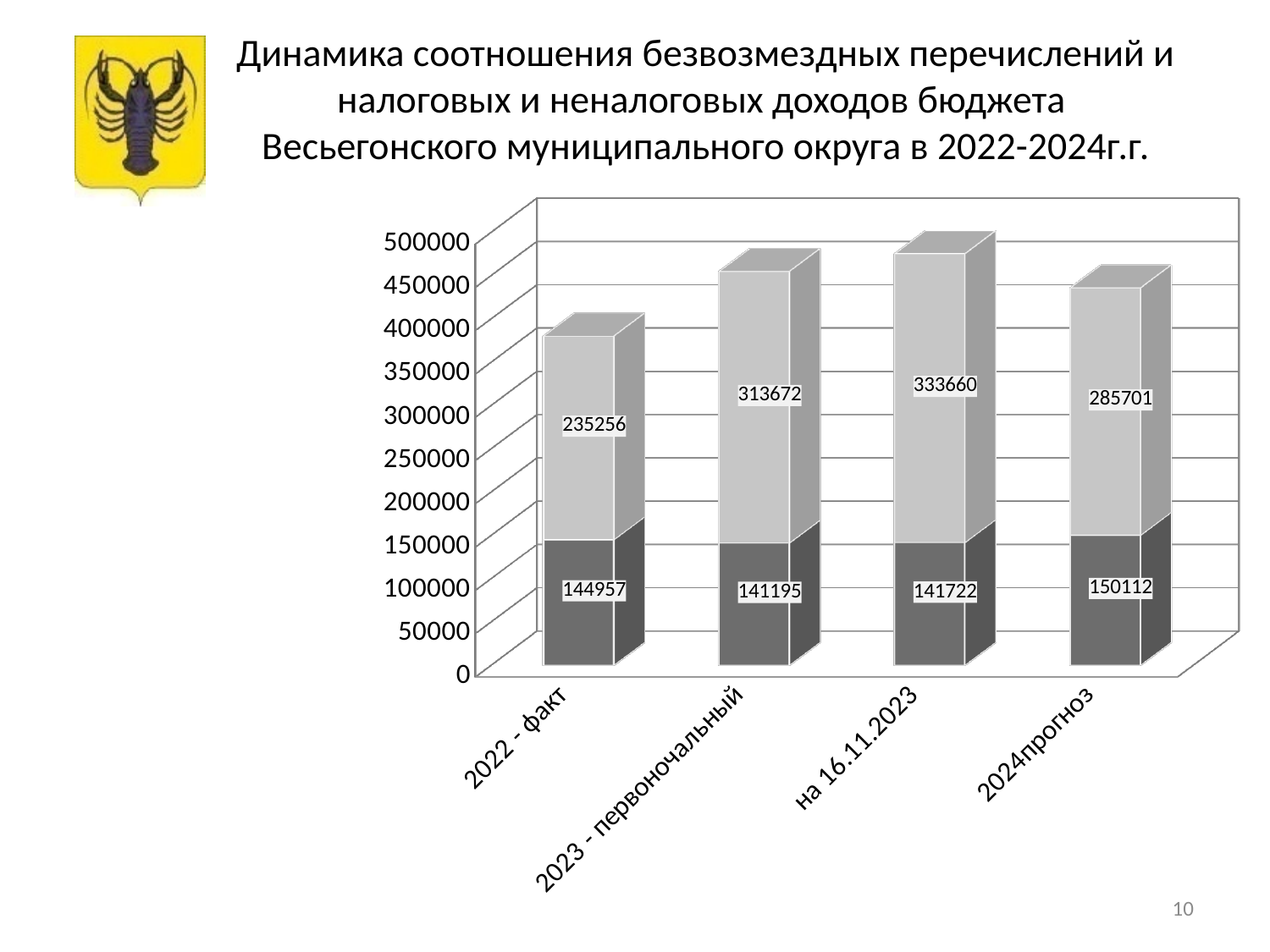
What is the value of the light grey upper segment for "2024прогноз"? 285701 What is the total of the stacked bar for "на 16.11.2023"? 475382 Which category has the largest light grey upper segment? на 16.11.2023 What is the total of the stacked bar for "2022 - факт"? 380213 What is the value of the dark grey lower segment for "2022 - факт"? 144957 Which is larger: the dark grey lower segment for "2024прогноз" or for "2022 - факт"? 2024прогноз Which category has the smallest dark grey lower segment? 2023 - первоночальный What is the difference between the light grey upper segment for "2023 - первоночальный" and for "2022 - факт"? 78416 How many categories are shown on the x axis of the chart? 4 What kind of chart is shown on the slide? Stacked bar chart What is the value of the light grey upper segment for "на 16.11.2023"? 333660 Which years does the chart title say the data covers? 2022-2024